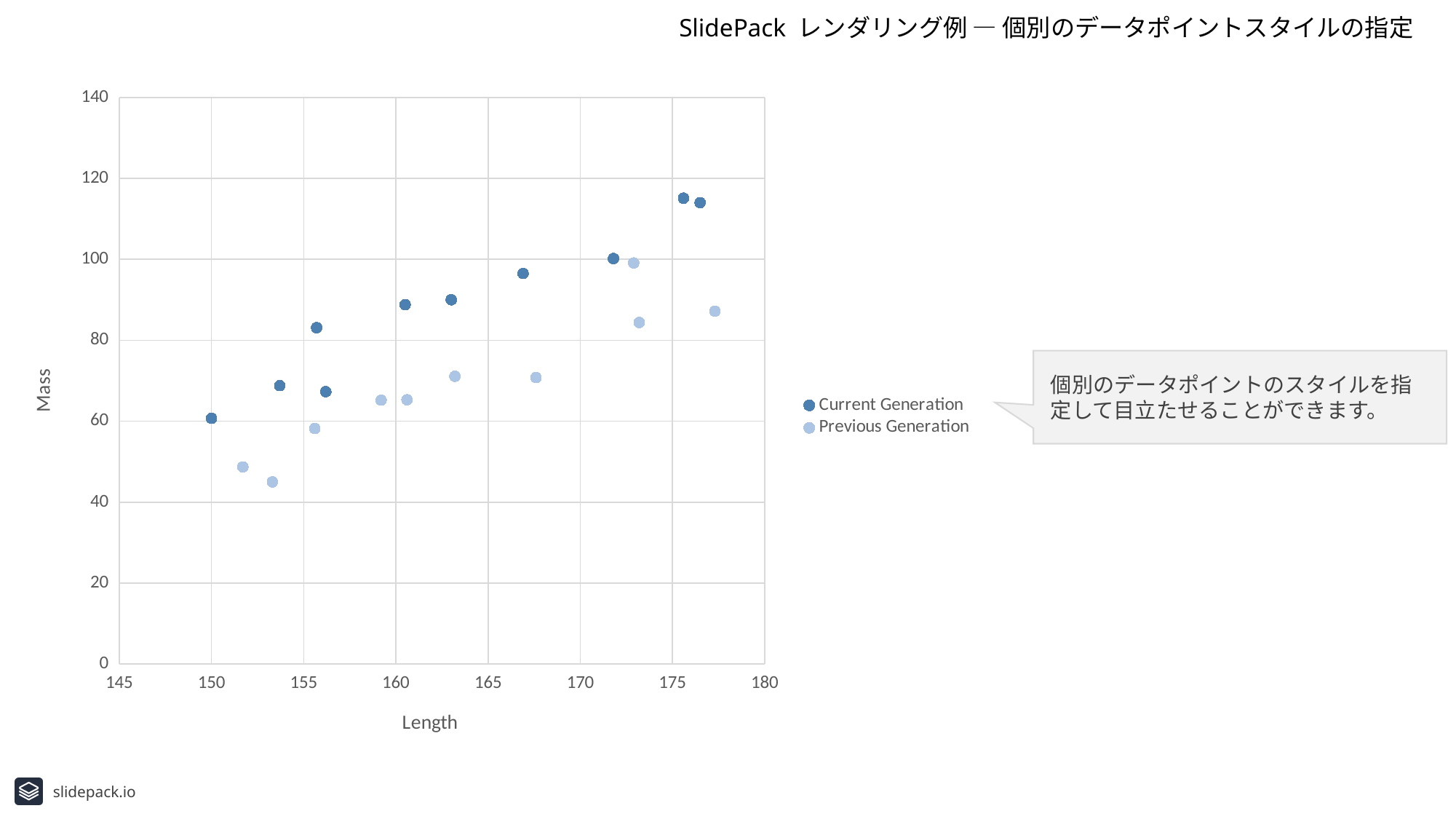
What is the title of the vertical axis? Mass Is any Previous Generation point above a Mass of 120? no Which series contains the point with the highest Mass? Current Generation What kind of chart is shown on the slide? scatter chart Do the Current Generation values generally rise or fall as Length increases? rise Is the Mass of the lowest Previous Generation point greater or less than 60? less How many series does the legend list? 2 What are the names of the two series in the legend? Current Generation, Previous Generation How many Current Generation points are plotted? 10 Is the Mass of the Current Generation point at Length 150 greater or less than 80? less Which series contains the point with the lowest Mass? Previous Generation